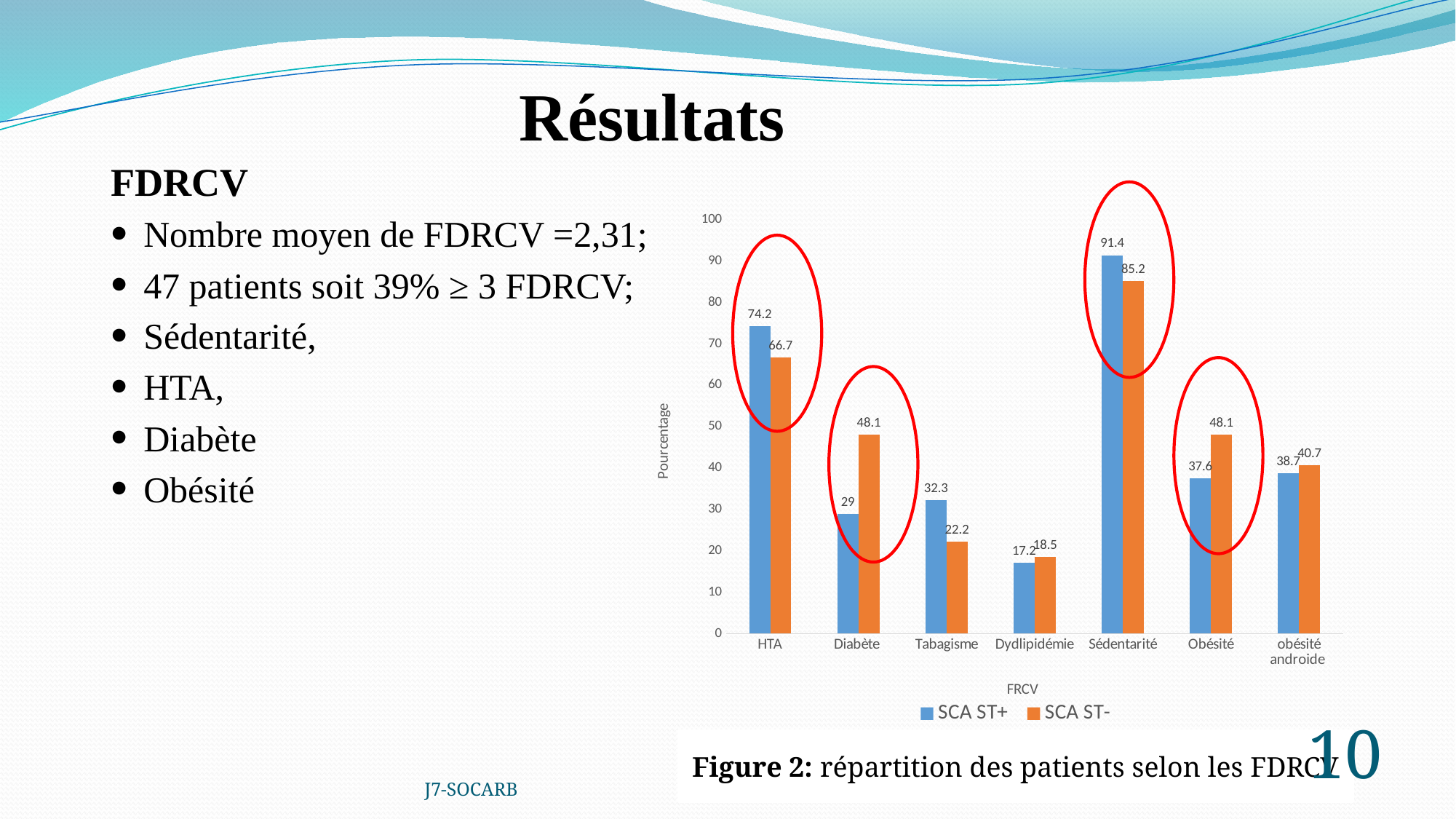
How many series does the legend list? 2 What is the SCA ST- value for Diabète? 48.1 What is the SCA ST+ value for HTA? 74.2 Which category has the lowest SCA ST- value? Dydlipidémie Which category has the highest SCA ST+ value? Sédentarité What kind of chart is shown on the slide? bar chart What is the SCA ST- value for obésité androide? 40.7 What is the difference between the SCA ST+ and SCA ST- values for Sédentarité? 6.2 For Obésité, which series has the larger value, SCA ST+ or SCA ST-? SCA ST- What is the label of the y axis? Pourcentage What is the SCA ST+ value for Tabagisme? 32.3 How many categories are shown on the x axis? 7